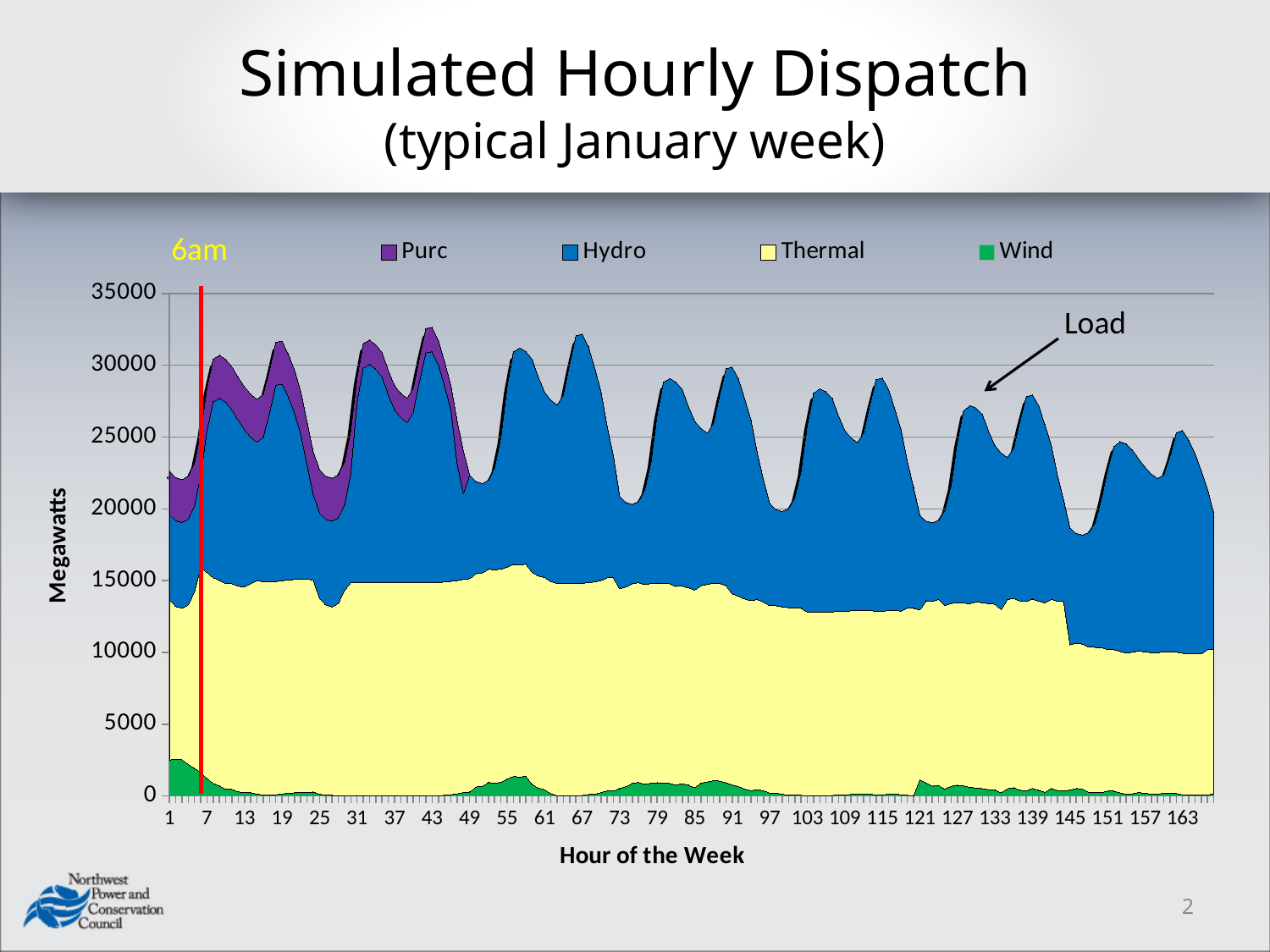
Is the top of the Thermal layer at hour 163 greater or less than 15000 megawatts? less Is the highest peak of the total load during the week greater or less than 30000 megawatts? greater What kind of chart is shown on the slide? Stacked area chart How many series does the legend list? 4 Is the Wind generation at hour 1 greater or less than 5000 megawatts? less Is the daily peak load around hour 163 larger or smaller than the daily peak load around hour 43? smaller What is the title of the chart? Simulated Hourly Dispatch (typical January week) Do the daily peaks of the total load generally rise or fall over the course of the week? fall What is the label of the vertical axis? Megawatts Which series is plotted as the bottom layer of the stack? Wind